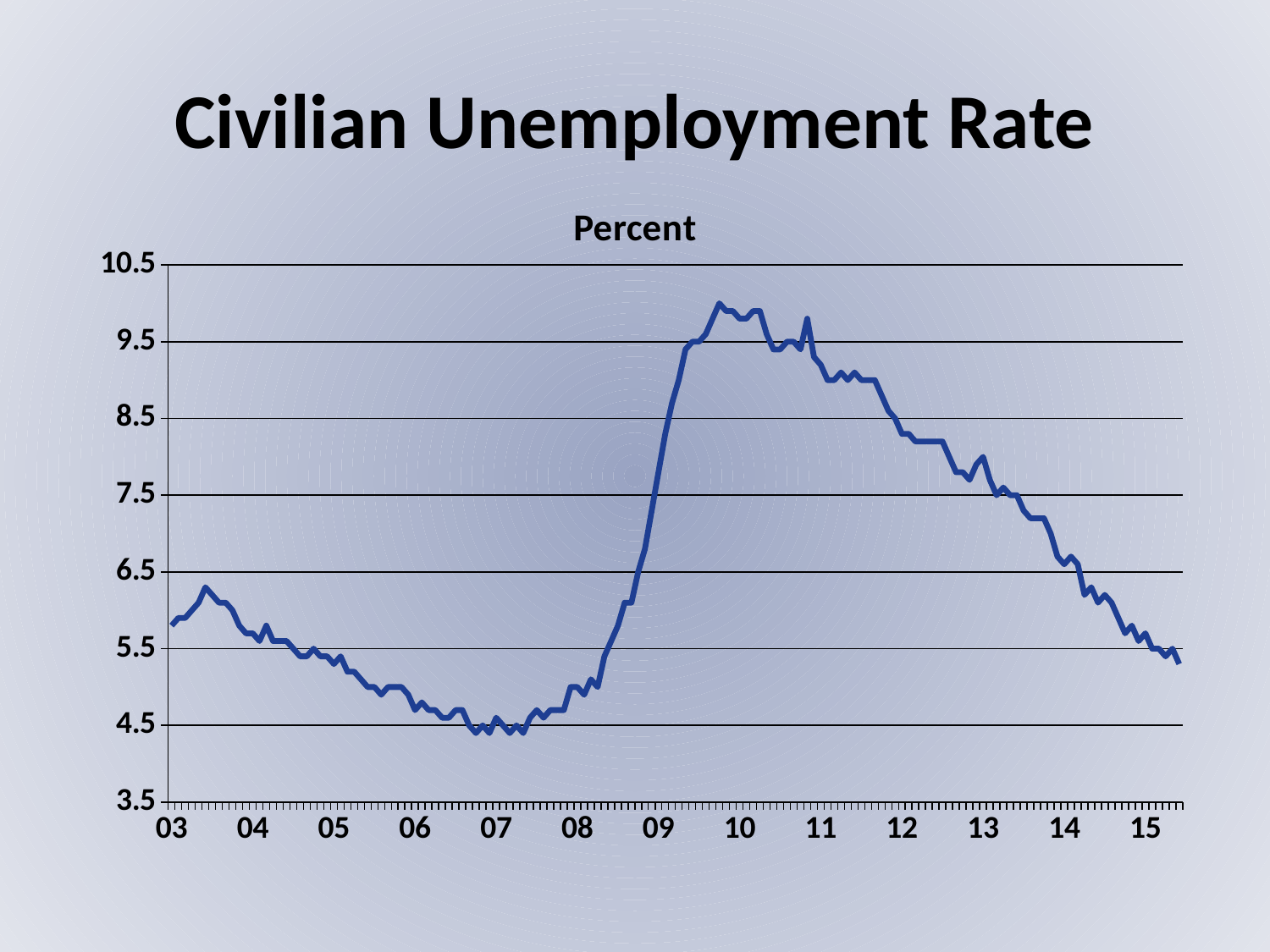
Is the value at the start of 2010 greater or less than 9.5? greater How many year labels appear along the x axis? 13 Which is larger, the unemployment rate at the start of 2010 or at the start of 2007? start of 2010 Is the value at the start of 2015 greater or less than 6.5? less Is the value at the start of 2003 greater or less than 5.5? greater What is the title of the chart? Civilian Unemployment Rate Does the unemployment rate rise or fall between 2008 and 2009? rise What kind of chart is shown on the slide? line chart Does the unemployment rate rise or fall between 2010 and 2015? fall What unit label is shown above the chart's vertical axis? Percent How many lines are plotted on the chart? 1